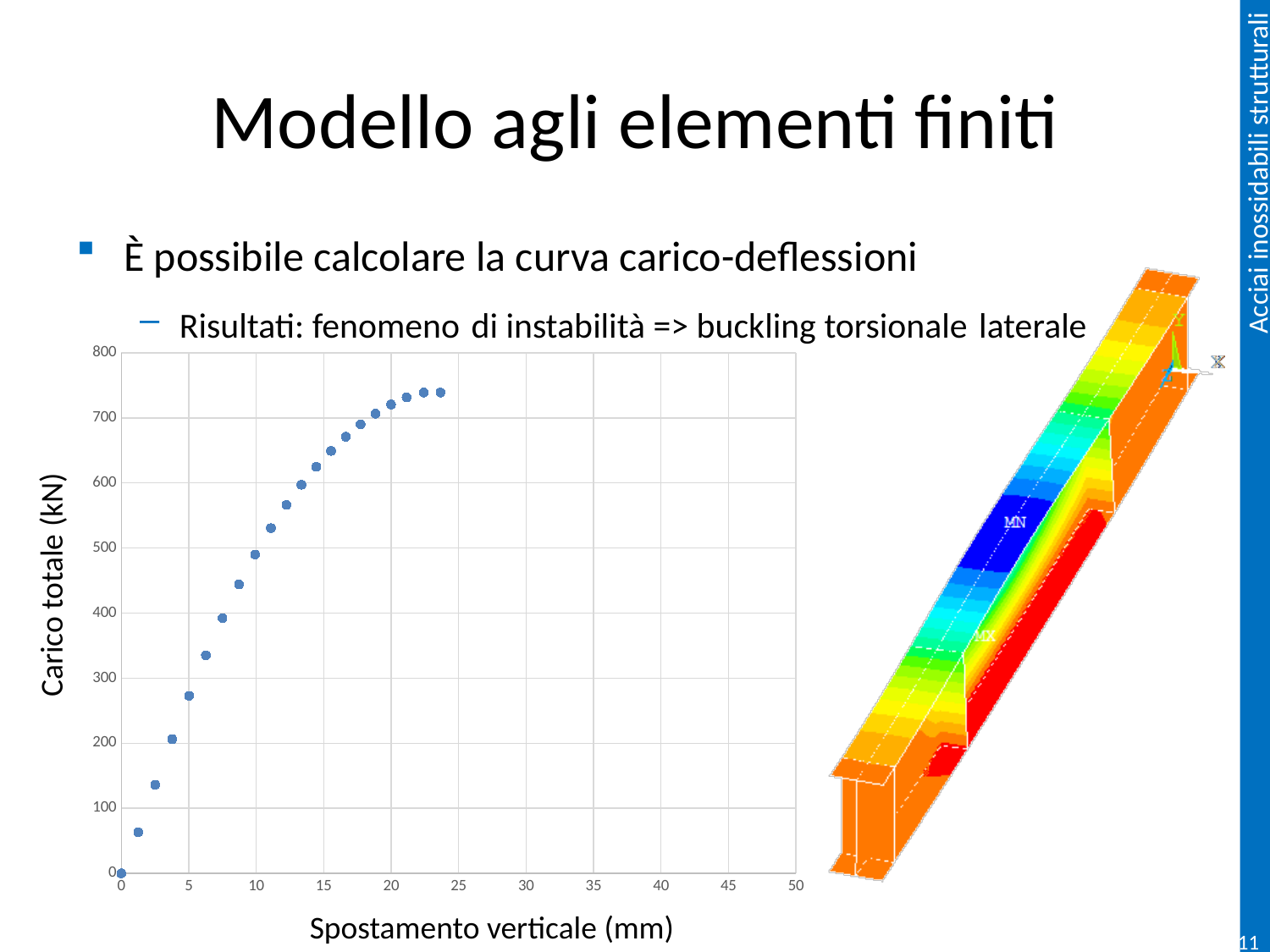
Is the load at a vertical displacement of 15 mm greater or less than 600 kN? greater What is the label of the vertical axis of the chart? Carico totale (kN) Is the load at a vertical displacement of 5 mm greater or less than 300 kN? less What is the maximum value shown on the vertical axis of the chart? 800 Is the largest vertical displacement plotted greater or less than 25 mm? less What kind of chart is shown on the slide? scatter chart Which has the larger load: the point at about 5 mm displacement or the point at about 20 mm displacement? the point at about 20 mm Does the load (Carico totale) rise or fall as the vertical displacement increases along the x axis? rise What is the label of the horizontal axis of the chart? Spostamento verticale (mm) What is the load value at a vertical displacement of 0 mm? 0